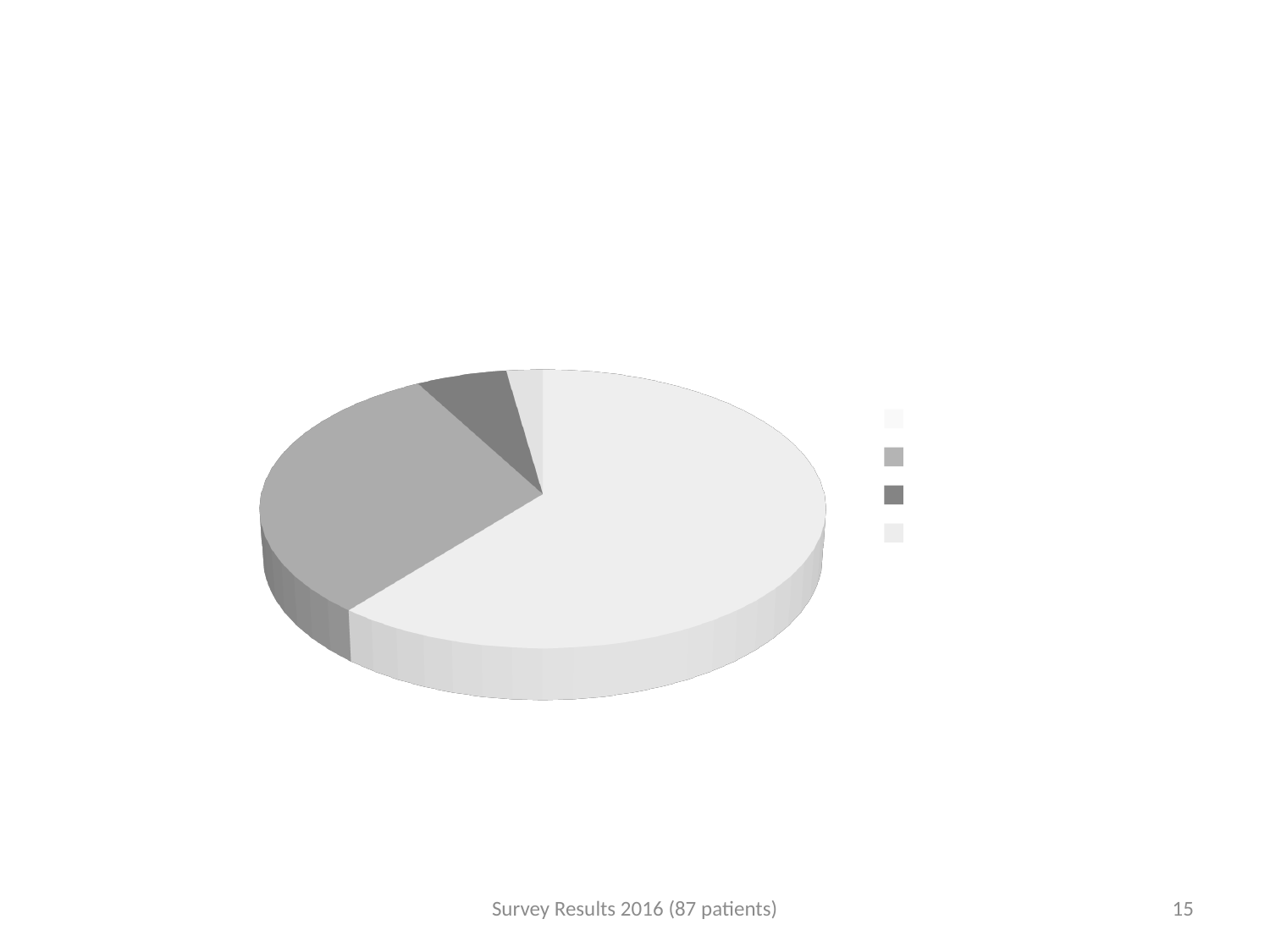
Does the pie chart have a title? No Does the largest slice cover more or less than half of the pie? more Which slice is larger, the light grey slice or the medium grey slice? the light grey slice How many entries does the legend list? 4 What kind of chart is shown on the slide? pie chart Are any data labels printed on the pie slices? No How many slices does the pie chart have? 4